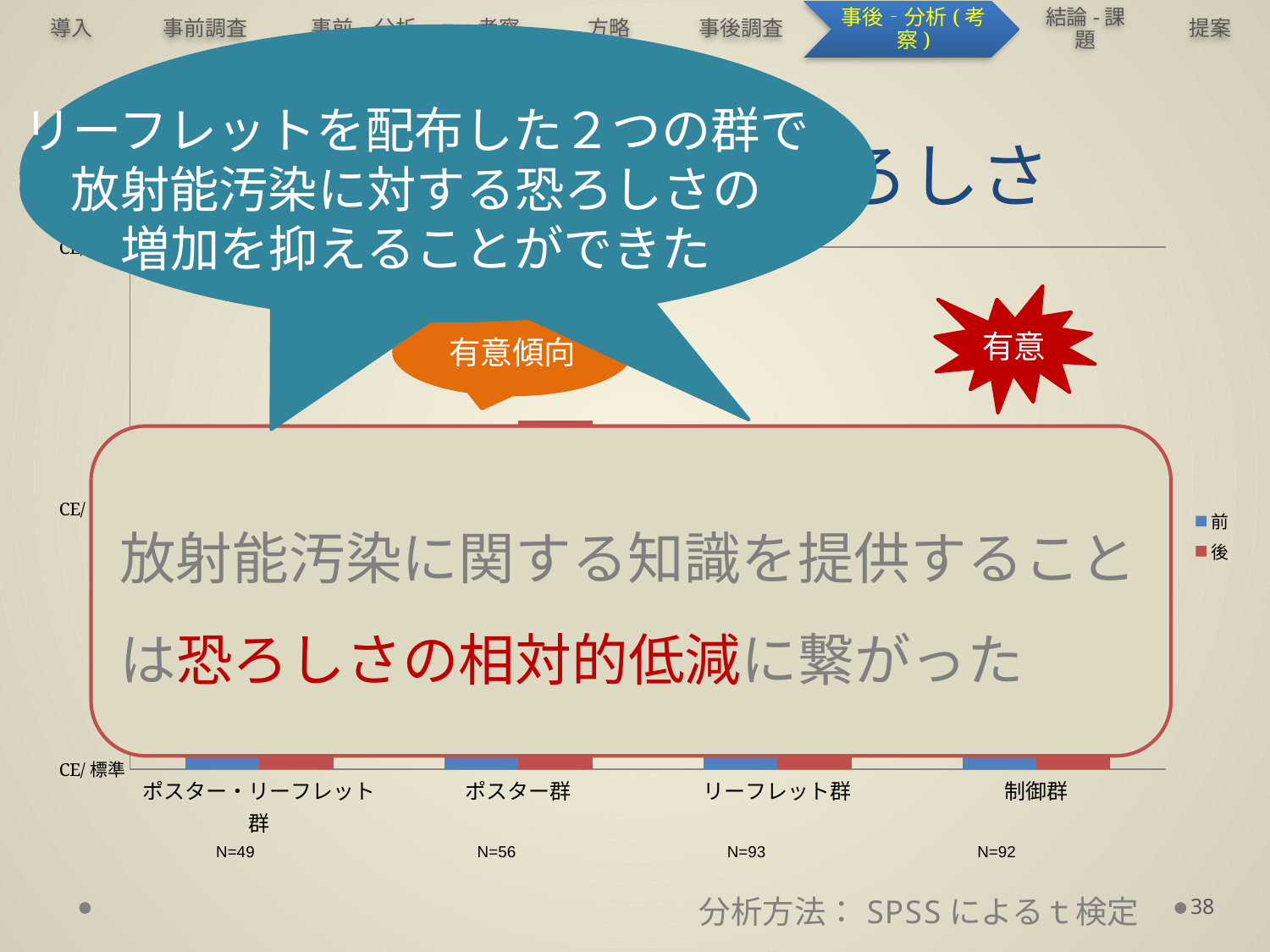
How many series does the chart's legend list? 2 What sample size (N) is printed under the 制御群 category? N=92 Which category has the smallest sample size (N) printed beneath it? ポスター・リーフレット群 What are the two series named in the chart's legend? 前 and 後 Which colour represents the 後 series in the chart? red What sample size (N) is printed under the ポスター群 category? N=56 What sample size (N) is printed under the リーフレット群 category? N=93 What sample size (N) is printed under the ポスター・リーフレット群 category? N=49 How many groups (categories) are shown along the x axis of the chart? 4 Which category has the largest sample size (N) printed beneath it? リーフレット群 What kind of chart is shown on the slide? bar chart